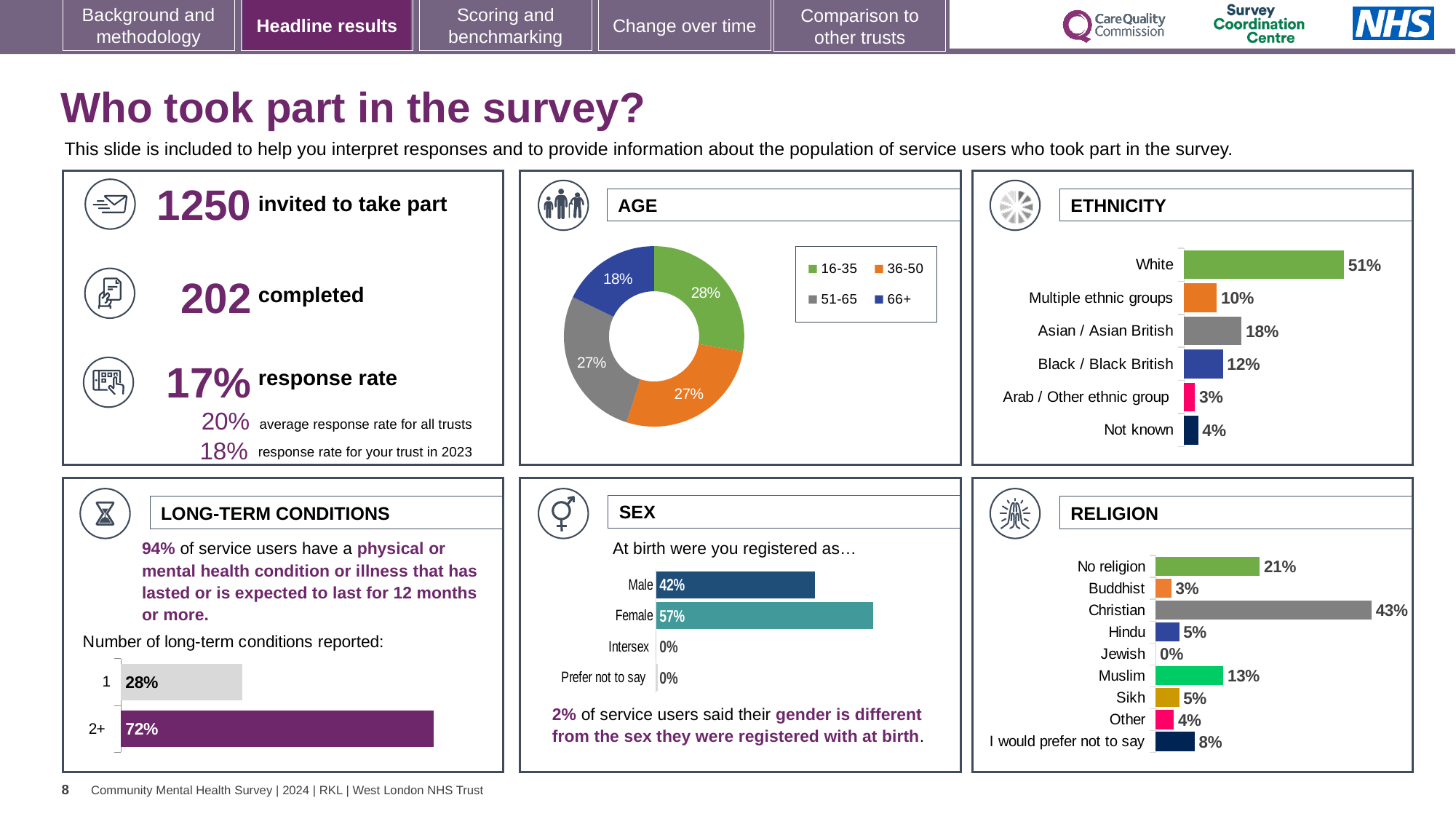
In the ETHNICITY chart, what is the difference between White and Black / Black British? 39% What kind of chart is the AGE chart? Doughnut chart In the LONG-TERM CONDITIONS chart, what is the value for 2+ conditions? 72% In the AGE chart, which age group has the smallest share? 66+ In the RELIGION chart, what is the value for Muslim? 13% In the ETHNICITY chart, what is the value for Asian / Asian British? 18% In the RELIGION chart, which category has the highest value? Christian In the AGE chart, what share of respondents were aged 16-35? 28% In the SEX chart, which is larger, Male or Female? Female In the ETHNICITY chart, which category has the highest value? White How many categories are shown in the ETHNICITY chart? 6 How many entries does the legend of the AGE chart list? 4